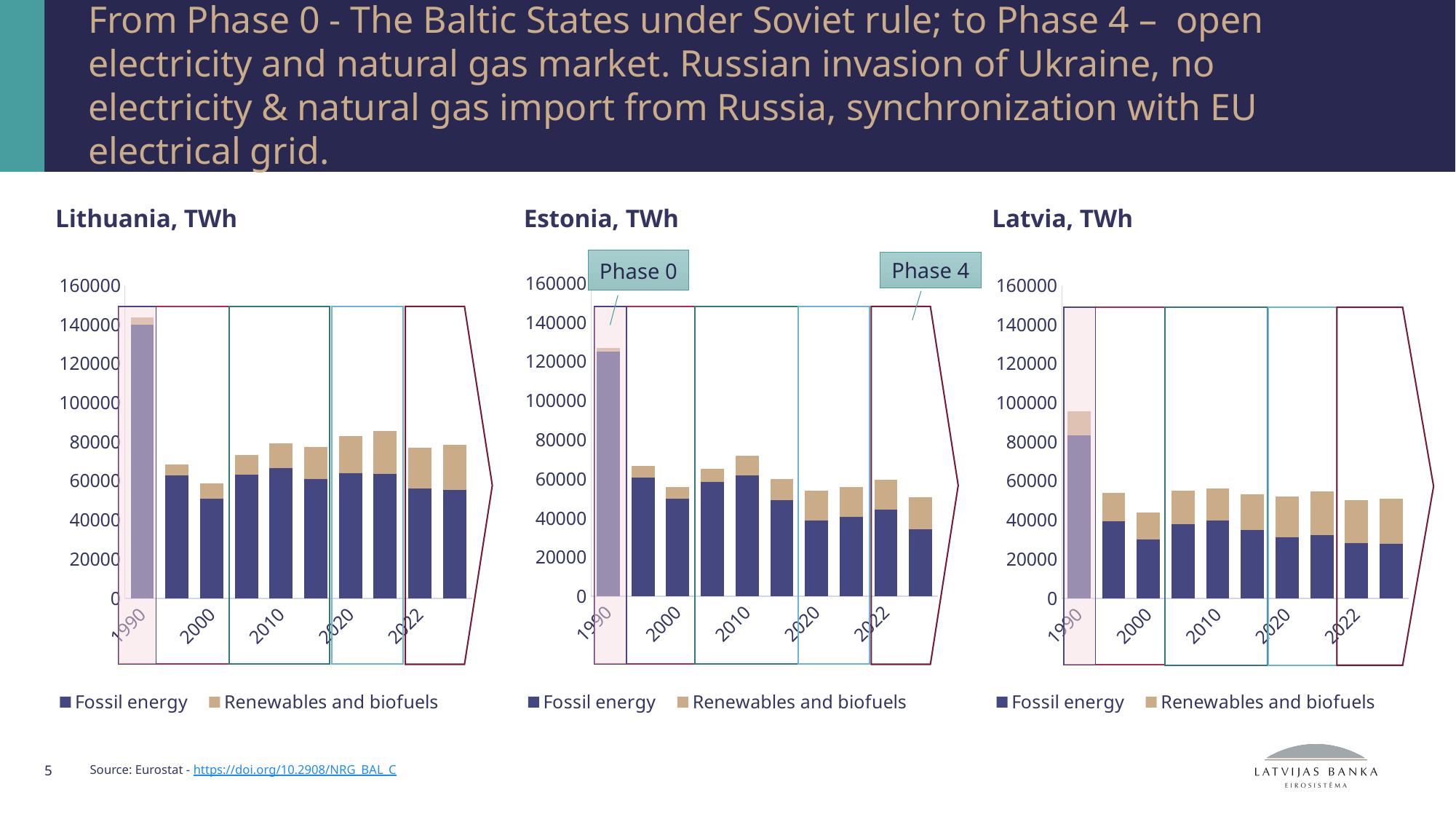
How many charts are shown on the slide? 3 What are the two legend entries in the Latvia, TWh chart? Fossil energy; Renewables and biofuels What kind of chart is the Lithuania, TWh chart? Stacked bar chart In the Latvia, TWh chart, which year has the highest total bar? 1990 How many series does the legend of the Estonia, TWh chart list? 2 In the Lithuania, TWh chart, which is larger, the total bar for 1990 or the total bar for 2000? 1990 In the Estonia, TWh chart, is the Fossil energy value for 2022 greater or less than 40000? greater In the Lithuania, TWh chart, is the total value for 1990 greater or less than 120000? greater In the Estonia, TWh chart, which is larger, the Fossil energy value for 2000 or for 2022? 2000 In the Estonia, TWh chart, which year has the highest total bar? 1990 In the Latvia, TWh chart, does the Fossil energy value rise or fall from 1990 to 2022? Fall In the Latvia, TWh chart, is the total value for 1990 greater or less than 100000? less